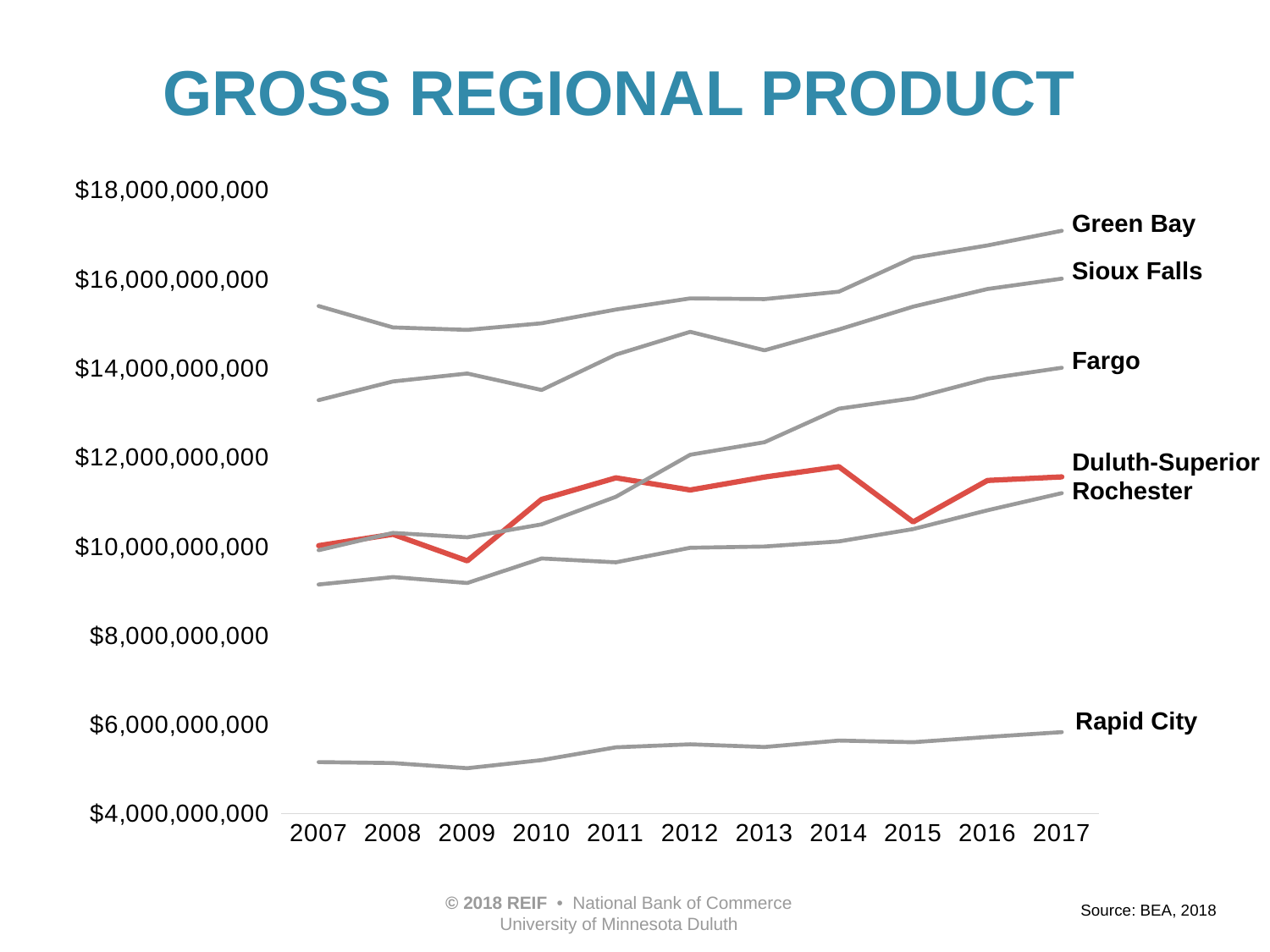
How many regions (series) are plotted on the chart? 6 Is the value for Rochester in 2007 greater or less than $10,000,000,000? less Which region's line is drawn in red on the chart? Duluth-Superior How many years are shown on the x axis of the chart? 11 What kind of chart is shown on the slide? line chart Is the value for Green Bay in 2017 greater or less than $16,000,000,000? greater Which region has the highest gross regional product in 2017? Green Bay In 2014, which is larger: the value for Duluth-Superior or the value for Rochester? Duluth-Superior Is the value for Rapid City in 2017 greater or less than $6,000,000,000? less Which region has the lowest gross regional product across the chart? Rapid City Does the value for Fargo generally rise or fall from 2007 to 2017? rise